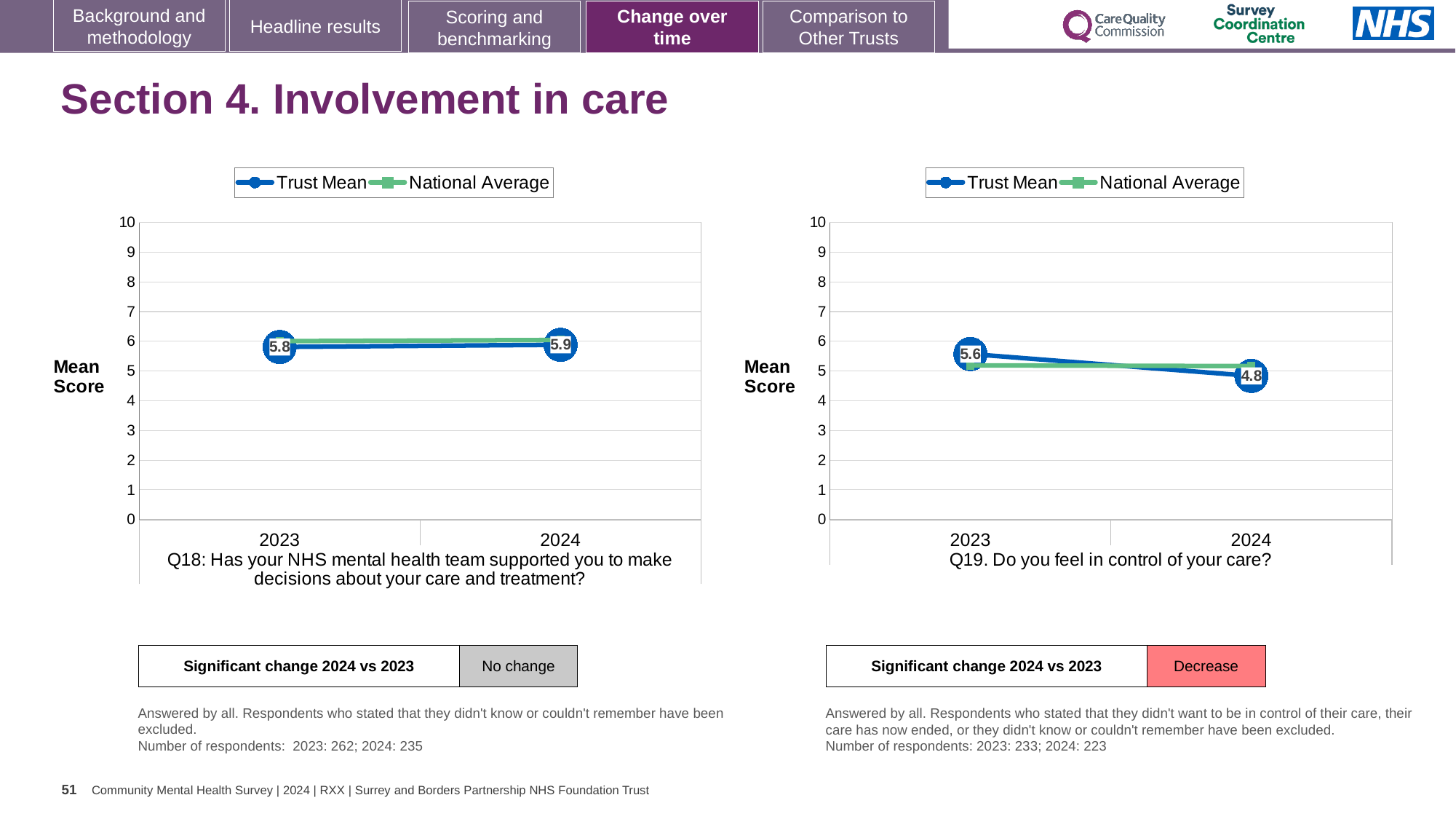
How many series does the legend of the Q19 chart on the right list? 2 In the Q18 chart on the left, what is the difference between the Trust Mean scores for 2024 and 2023? 0.1 What type of chart is used for Q18 on the left? line chart In the Q19 chart on the right, does the Trust Mean rise or fall from 2023 to 2024? fall In the Q19 chart on the right, by how much did the Trust Mean score fall from 2023 to 2024? 0.8 In the Q18 chart on the left, what is the Trust Mean score for 2023? 5.8 How many years are plotted on the x axis of the Q18 chart on the left? 2 In the Q19 chart on the right, which year has the higher Trust Mean score, 2023 or 2024? 2023 In the Q18 chart on the left, what is the Trust Mean score for 2024? 5.9 In the Q19 chart on the right, what is the Trust Mean score for 2024? 4.8 In the Q18 chart on the left, is the National Average for 2024 greater or less than 5? greater In the Q19 chart on the right, what is the Trust Mean score for 2023? 5.6